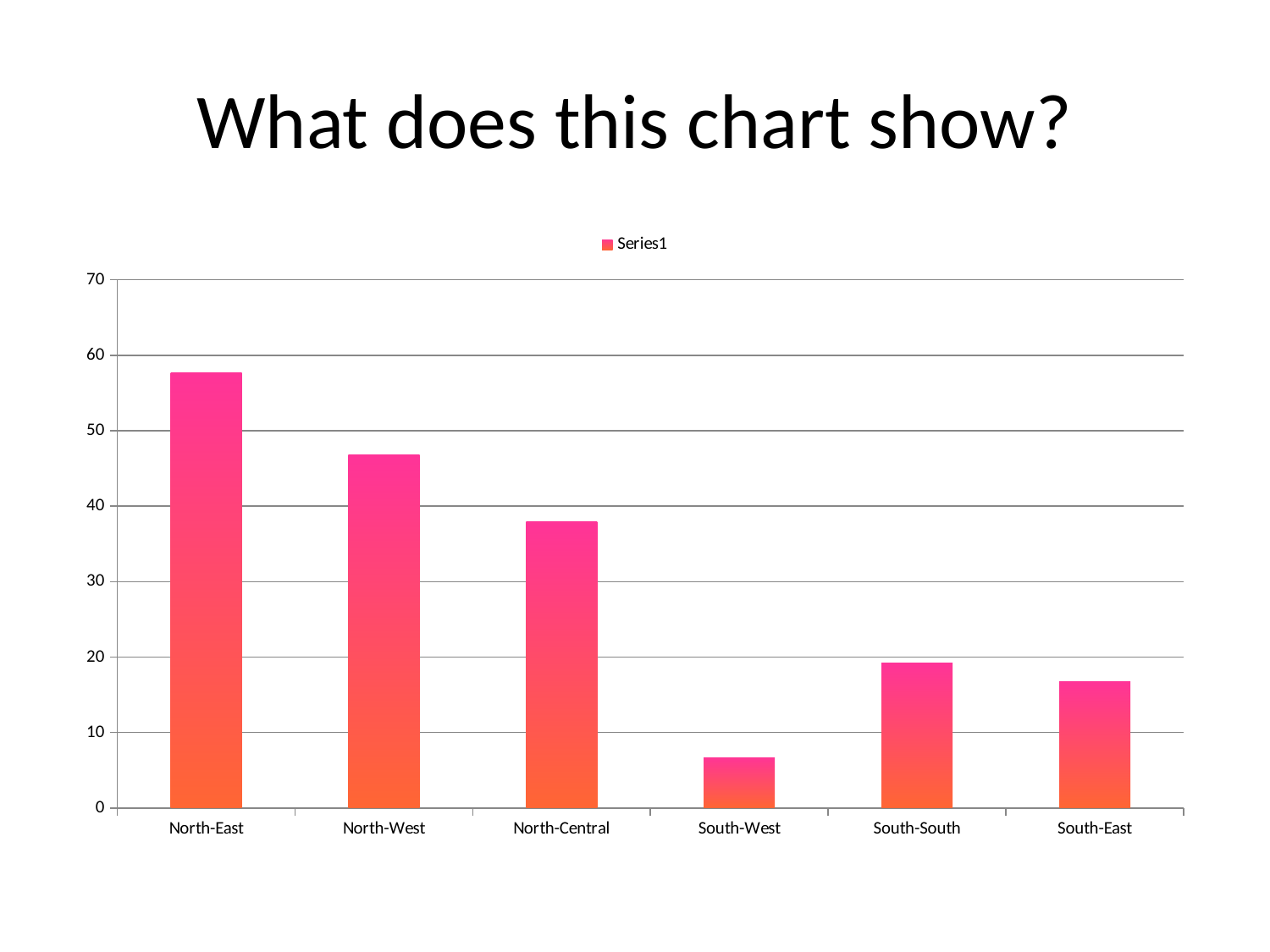
Is the value for North-Central greater or less than 40? less How many categories are shown on the x axis of the chart? 6 What is the name of the series shown in the chart's legend? Series1 Is the value for North-West greater or less than 40? greater How many series does the chart's legend list? 1 Is the value for South-West greater or less than 10? less Which category has the lowest value in the chart? South-West What kind of chart is shown on the slide? bar chart Which category has the highest value in the chart? North-East Which has the larger value, North-West or North-Central? North-West